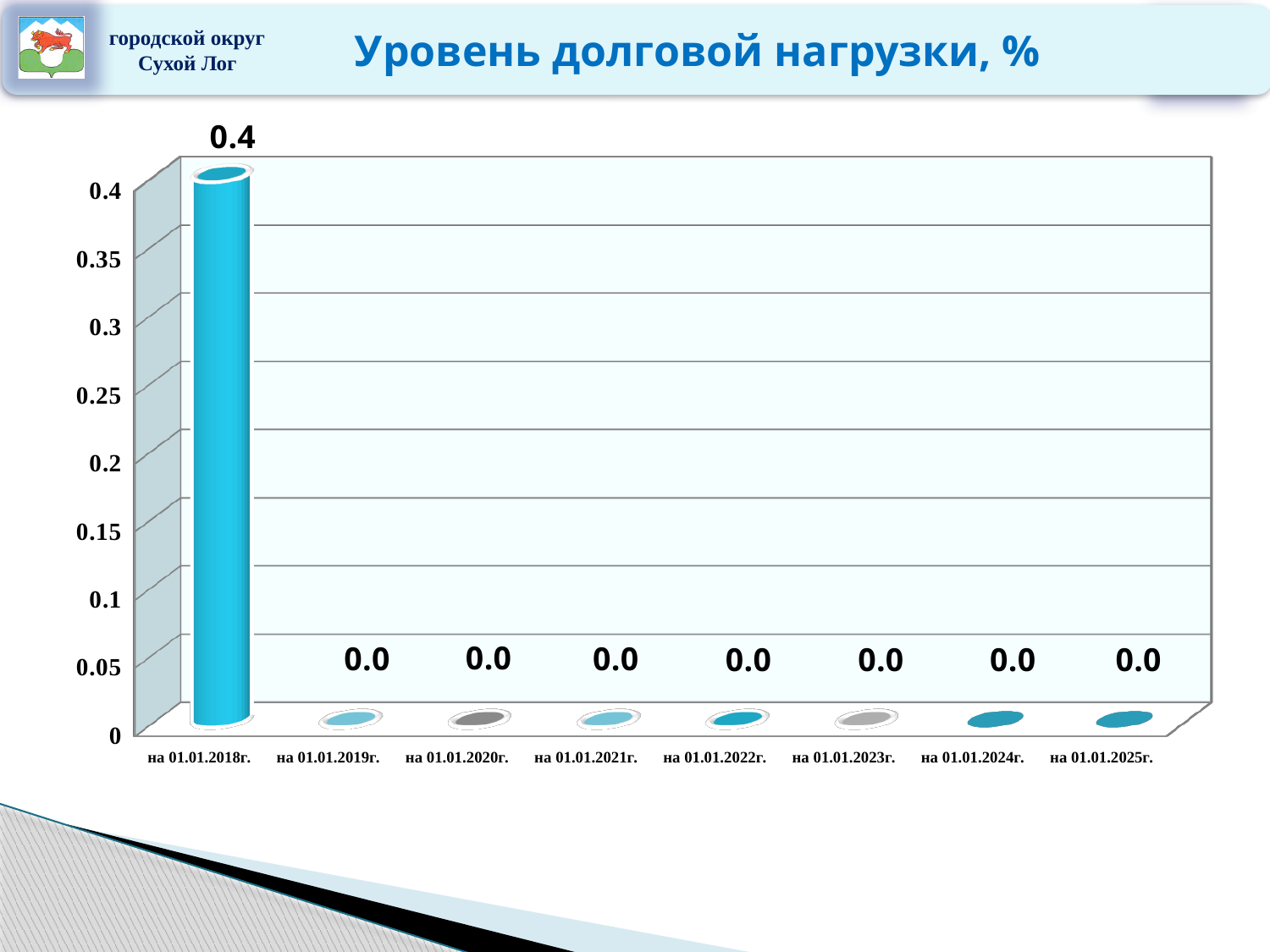
What is the value for на 01.01.2021г.? 0.0 What is the difference between the values for на 01.01.2018г. and на 01.01.2019г.? 0.4 Do the values rise or fall from на 01.01.2018г. to на 01.01.2019г.? fall What is the value for на 01.01.2025г.? 0.0 How many categories are shown on the x axis? 8 What is the title of the chart? Уровень долговой нагрузки, % Which is larger, the value for на 01.01.2018г. or the value for на 01.01.2023г.? на 01.01.2018г. How many categories have a value of 0.0? 7 What is the value for на 01.01.2018г.? 0.4 Is the value for на 01.01.2018г. greater or less than 0.3? greater Which category has the highest value? на 01.01.2018г. What kind of chart is shown on the slide? bar chart